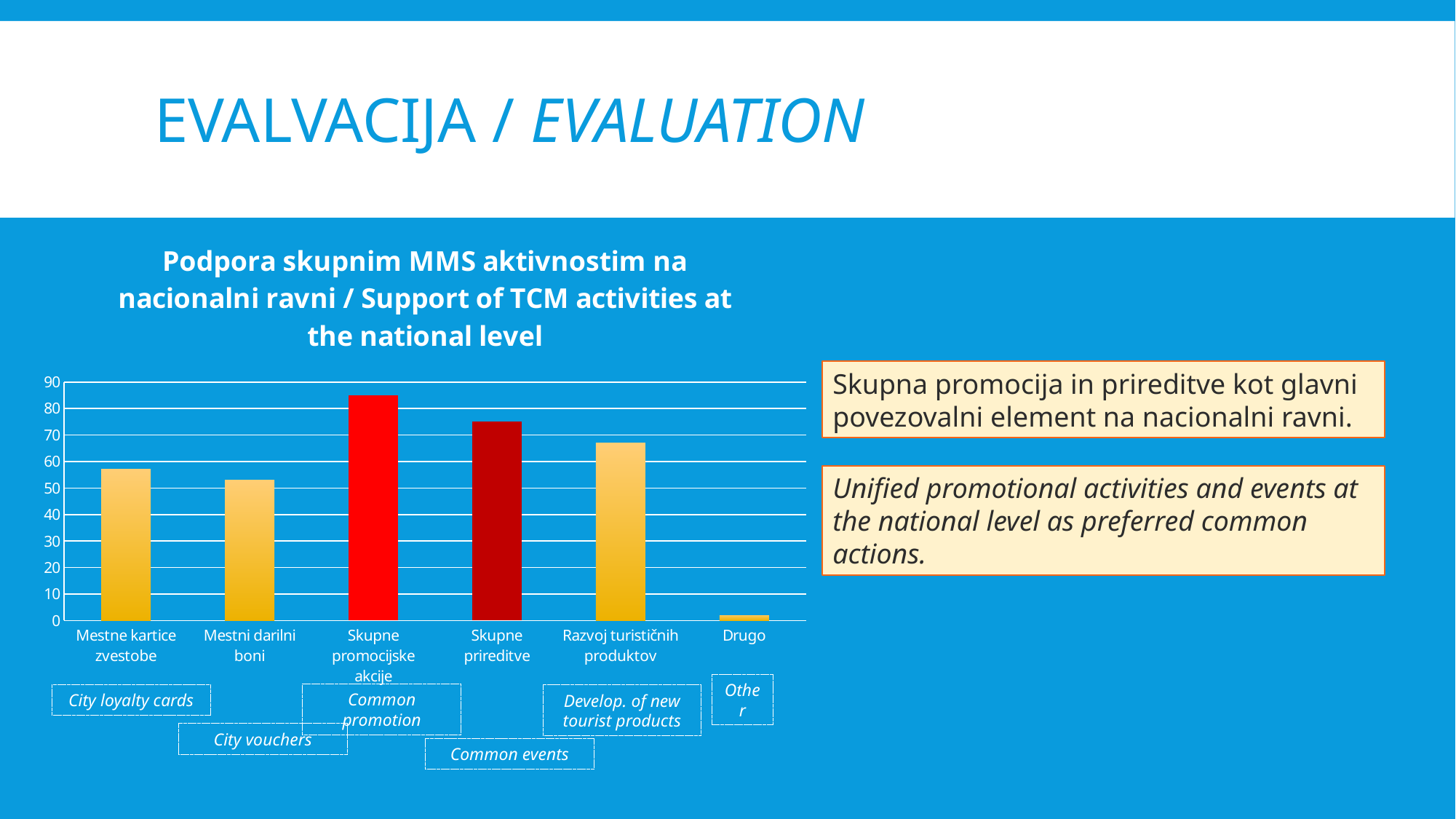
What kind of chart is shown on the slide? bar chart Is the value for Drugo greater or less than 10? less Is the value for Skupne promocijske akcije greater or less than 80? greater Which is larger, the value for Mestne kartice zvestobe or the value for Skupne promocijske akcije? Skupne promocijske akcije Which category has the lowest bar in the chart? Drugo Which is larger, the value for Skupne prireditve or the value for Razvoj turističnih produktov? Skupne prireditve How many categories are shown on the x axis of the chart? 6 Is the value for Razvoj turističnih produktov greater or less than 60? greater Which category has the highest bar in the chart? Skupne promocijske akcije Which two categories are drawn with red bars instead of yellow ones? Skupne promocijske akcije and Skupne prireditve What is the highest value shown on the y axis of the chart? 90